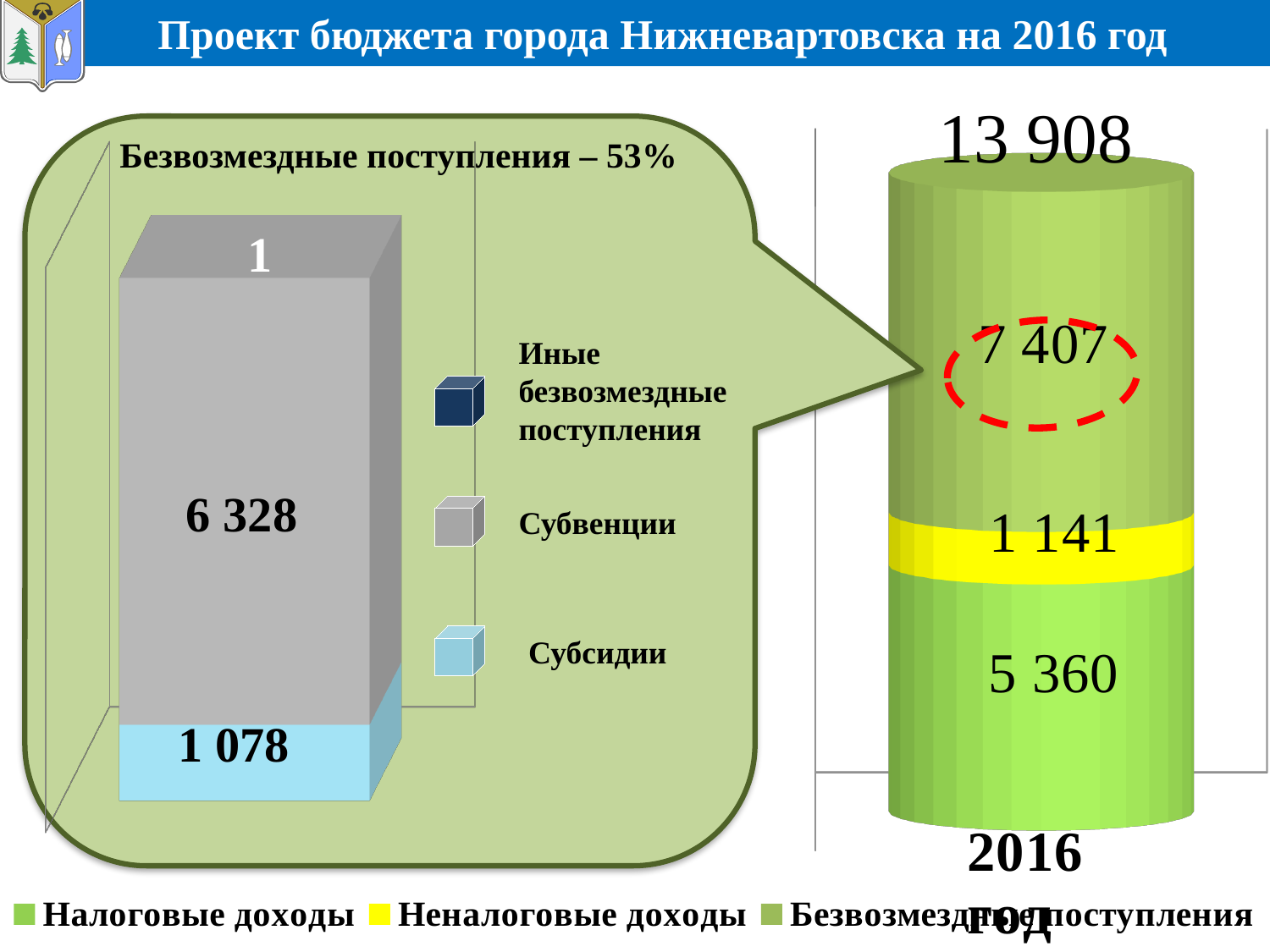
On the right-hand stacked bar chart, what is the value for Неналоговые доходы in 2016? 1 141 On the chart inside the callout on the left, what is the value for Субвенции? 6 328 What share of the budget do Безвозмездные поступления make up according to the callout title? 53% On the right-hand stacked bar chart, what is the value for Налоговые доходы in 2016? 5 360 On the right-hand stacked bar chart, which series has the largest value in 2016? Безвозмездные поступления On the right-hand stacked bar chart, what is the difference between Безвозмездные поступления and Налоговые доходы in 2016? 2 047 On the right-hand stacked bar chart, what is the total of the 2016 bar? 13 908 On the right-hand stacked bar chart, what is the value for Безвозмездные поступления in 2016? 7 407 How many series does the legend at the bottom of the slide list for the right-hand chart? 3 On the right-hand stacked bar chart, which series has the smallest value in 2016? Неналоговые доходы On the chart inside the callout on the left, what is the value for Субсидии? 1 078 On the chart inside the callout on the left, what is the value for Иные безвозмездные поступления? 1